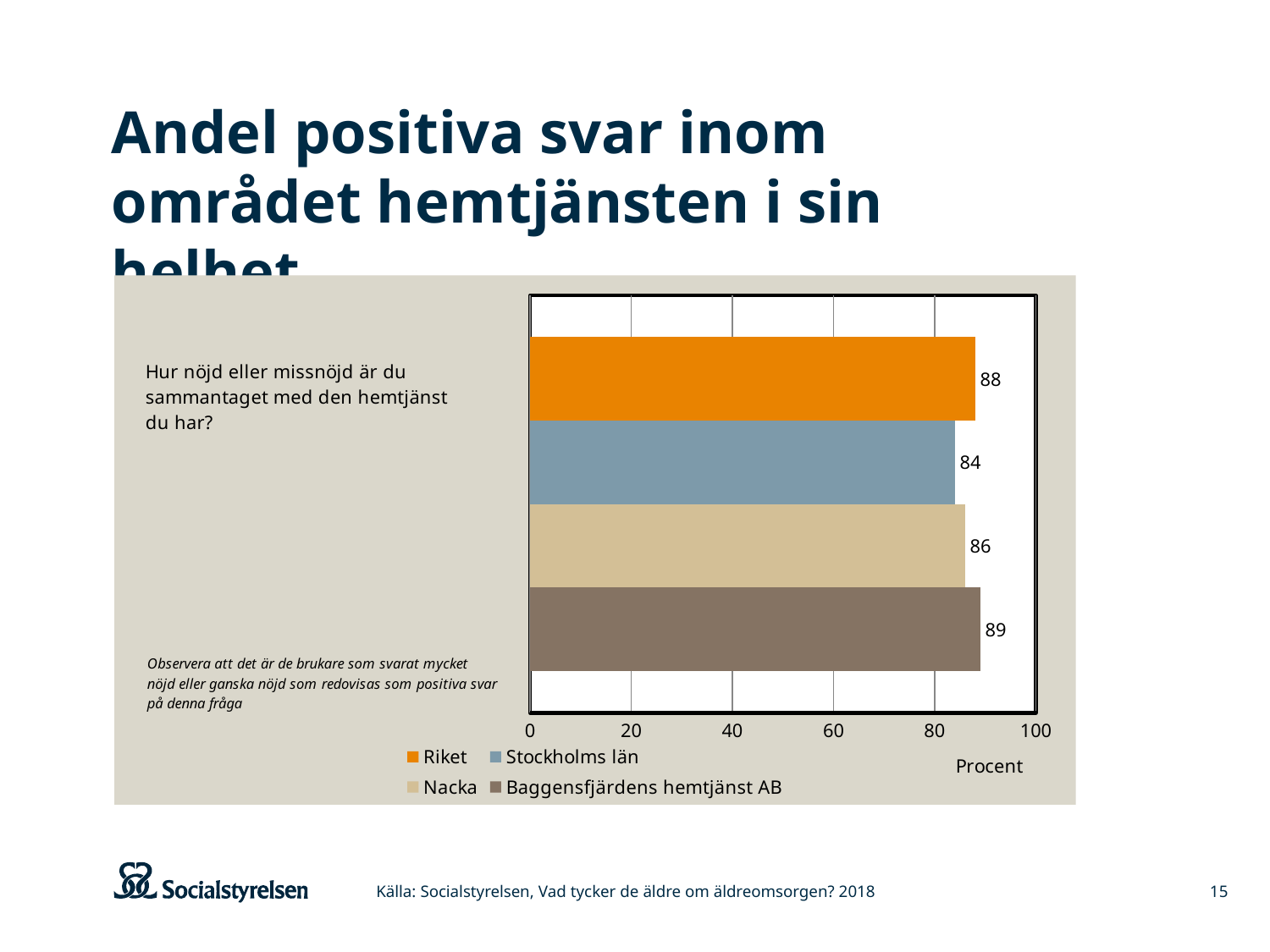
What is the label on the horizontal axis of the chart? Procent What kind of chart is shown on the slide? bar chart What is the value for Riket? 88 Which is larger, the value for Riket or the value for Nacka? Riket What is the difference between the values for Baggensfjärdens hemtjänst AB and Stockholms län? 5 What is the value for Baggensfjärdens hemtjänst AB? 89 What is the value for Stockholms län? 84 Which series has the lowest value? Stockholms län Which series has the highest value? Baggensfjärdens hemtjänst AB Is the value for Stockholms län greater or less than 80? greater What is the value for Nacka? 86 How many series does the legend list? 4